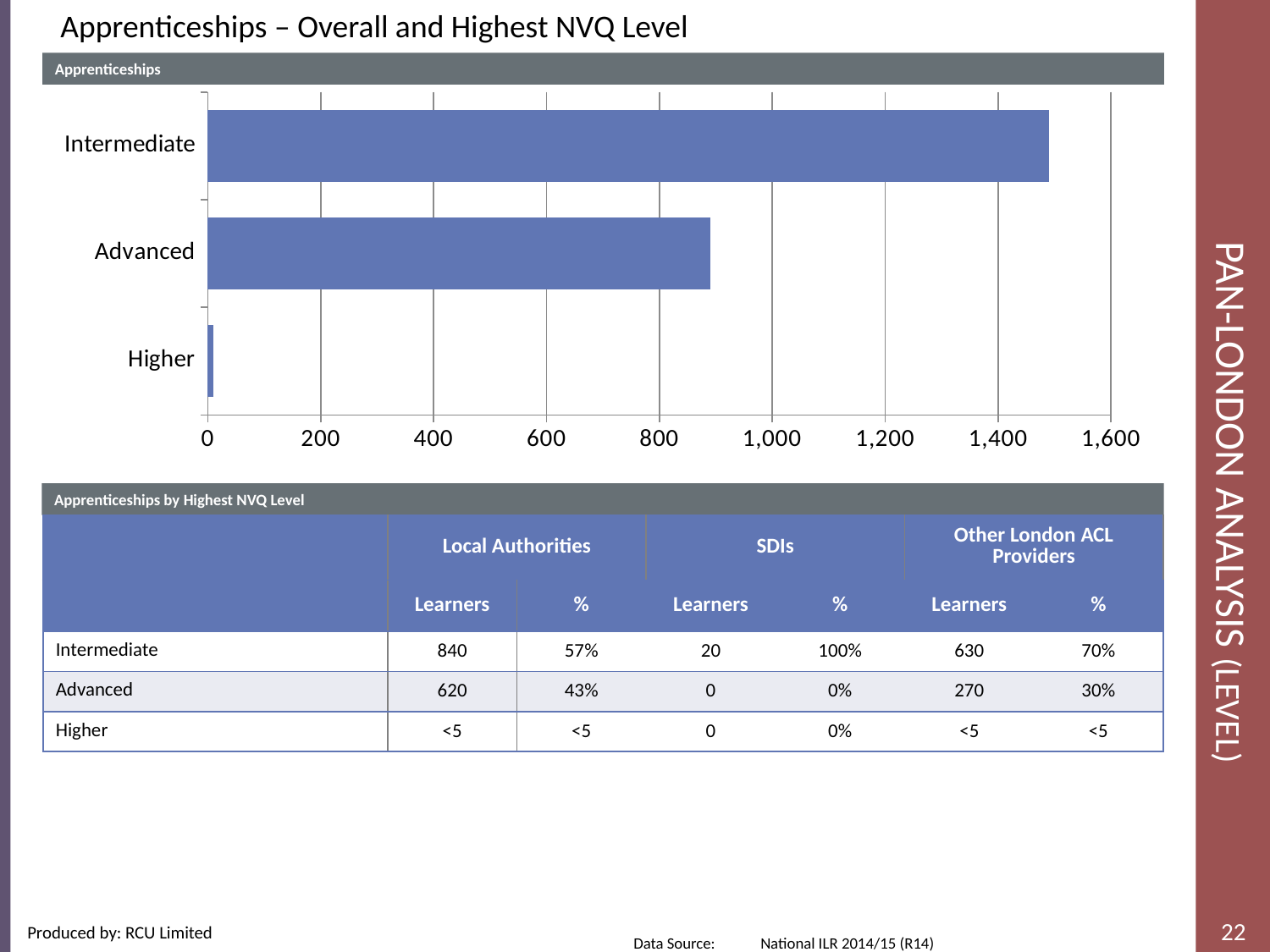
Which category has the lowest value in the bar chart? Higher Is the value for Advanced greater or less than 800? greater Is the value for Intermediate greater or less than 1,400? greater What is the title shown above the bar chart? Apprenticeships Is the value for Advanced greater or less than 1,000? less How many categories are plotted in the bar chart? 3 What kind of chart is shown on the slide? bar chart Which is larger in the bar chart, Intermediate or Advanced? Intermediate Which category has the highest value in the bar chart? Intermediate Which is larger in the bar chart, Advanced or Higher? Advanced What is the maximum value shown on the horizontal axis of the bar chart? 1,600